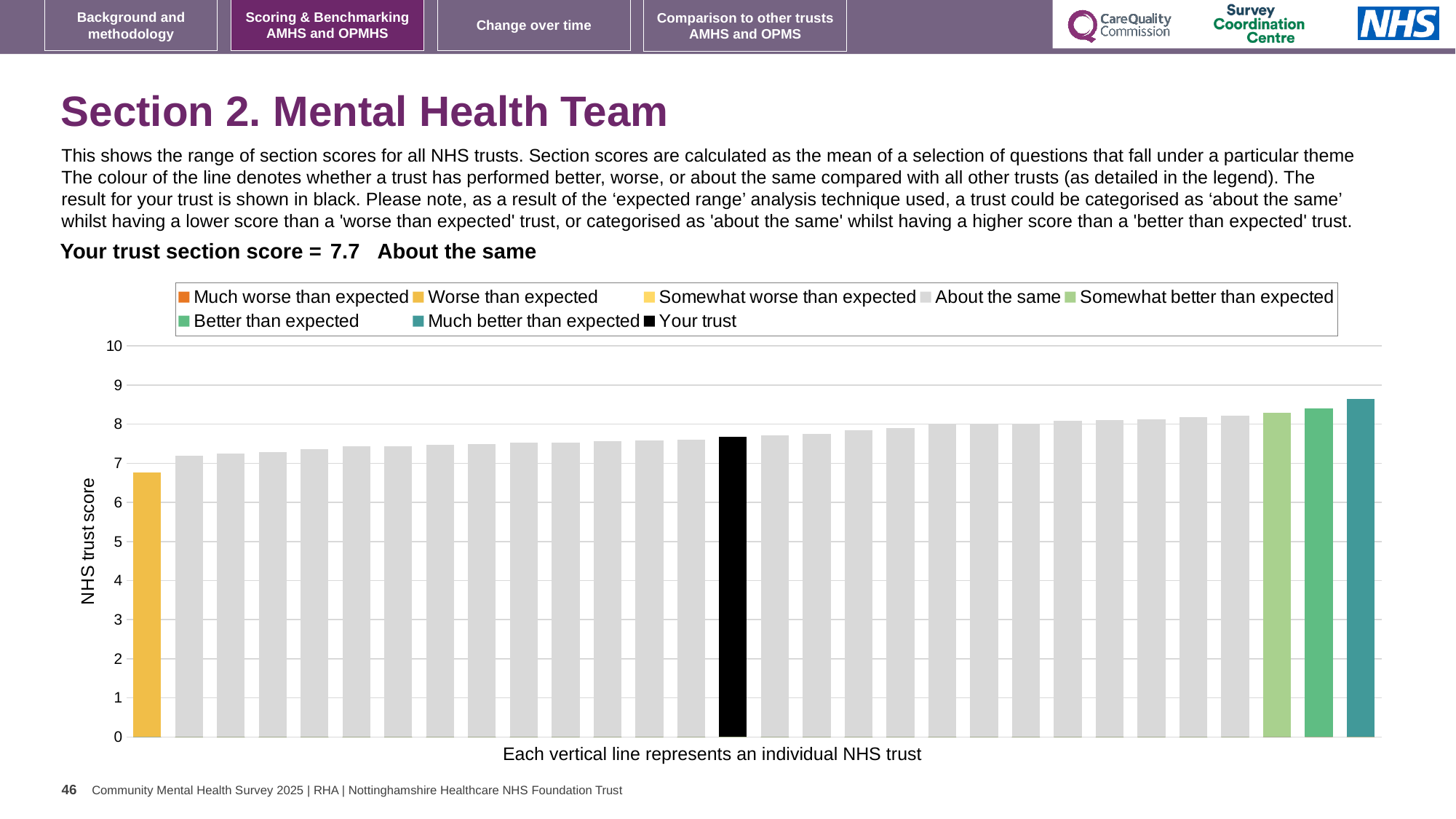
What is the section score for your trust shown on the slide? 7.7 Which legend category does the shortest bar belong to? Worse than expected Do the bar values rise or fall from left to right along the x axis? rise What colour is the bar representing your trust? black Is the value of the leftmost (yellow) bar greater or less than 7? less How many entries does the chart legend list? 8 Is the value of the bar for your trust greater or less than 7? greater Which legend category does the tallest bar belong to? Much better than expected What is the label on the vertical axis of the chart? NHS trust score Which is larger: the bar for your trust or the teal 'Much better than expected' bar? the teal 'Much better than expected' bar What kind of chart is shown on the slide? bar chart Is the value of the tallest bar greater or less than 8? greater